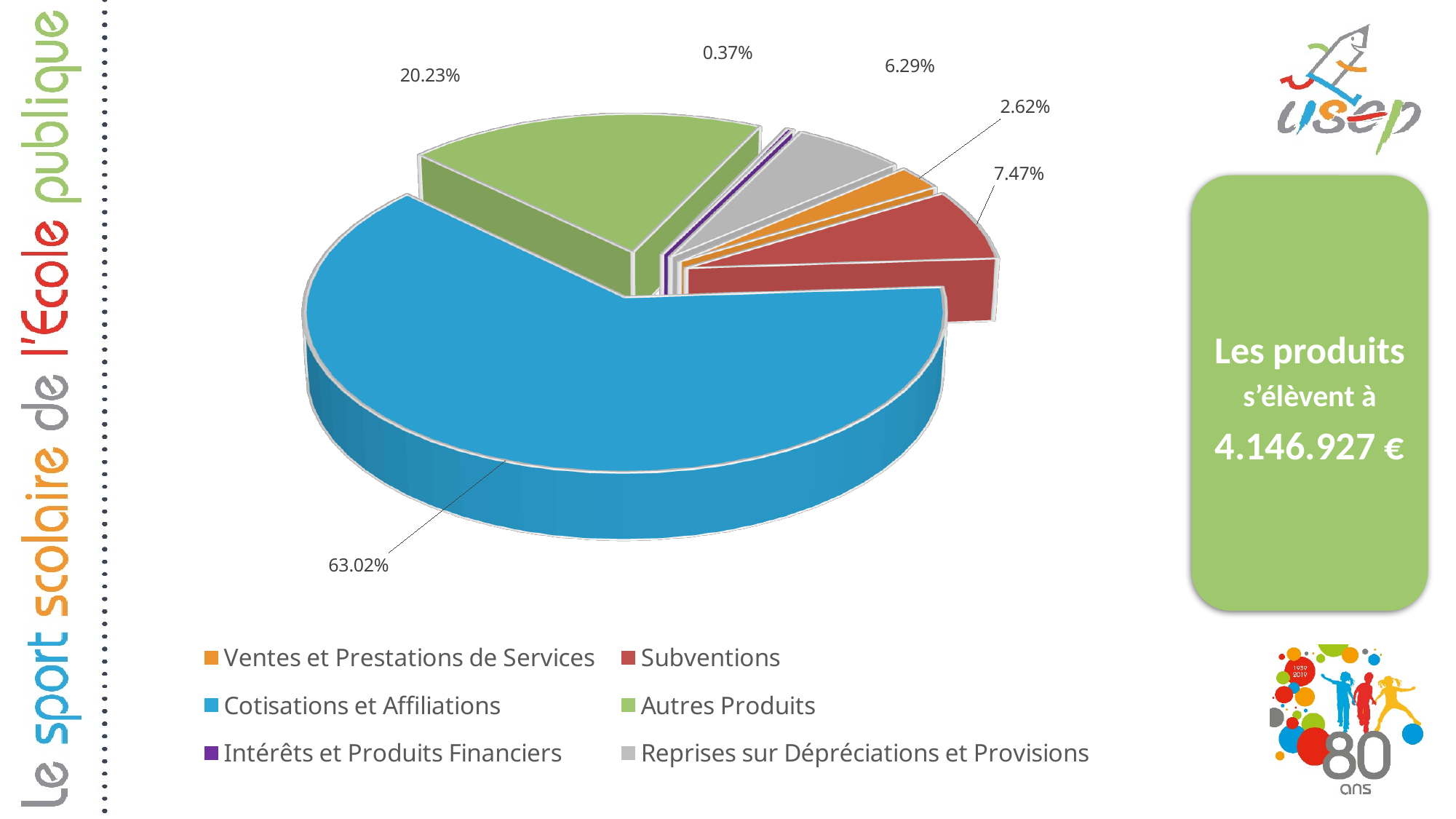
Which is larger, the share for Subventions or the share for Reprises sur Dépréciations et Provisions? Subventions How many categories does the legend list? 6 What kind of chart is shown on the slide? pie chart What is the value shown for Subventions? 7.47% Which category has the largest slice of the pie? Cotisations et Affiliations What is the value shown for Reprises sur Dépréciations et Provisions? 6.29% What share of the pie does Autres Produits represent? 20.23% What is the difference between the shares of Cotisations et Affiliations and Autres Produits? 42.79% What is the value shown for Intérêts et Produits Financiers? 0.37% Which category has the smallest slice of the pie? Intérêts et Produits Financiers What is the value shown for Ventes et Prestations de Services? 2.62% What share of the pie does Cotisations et Affiliations represent? 63.02%